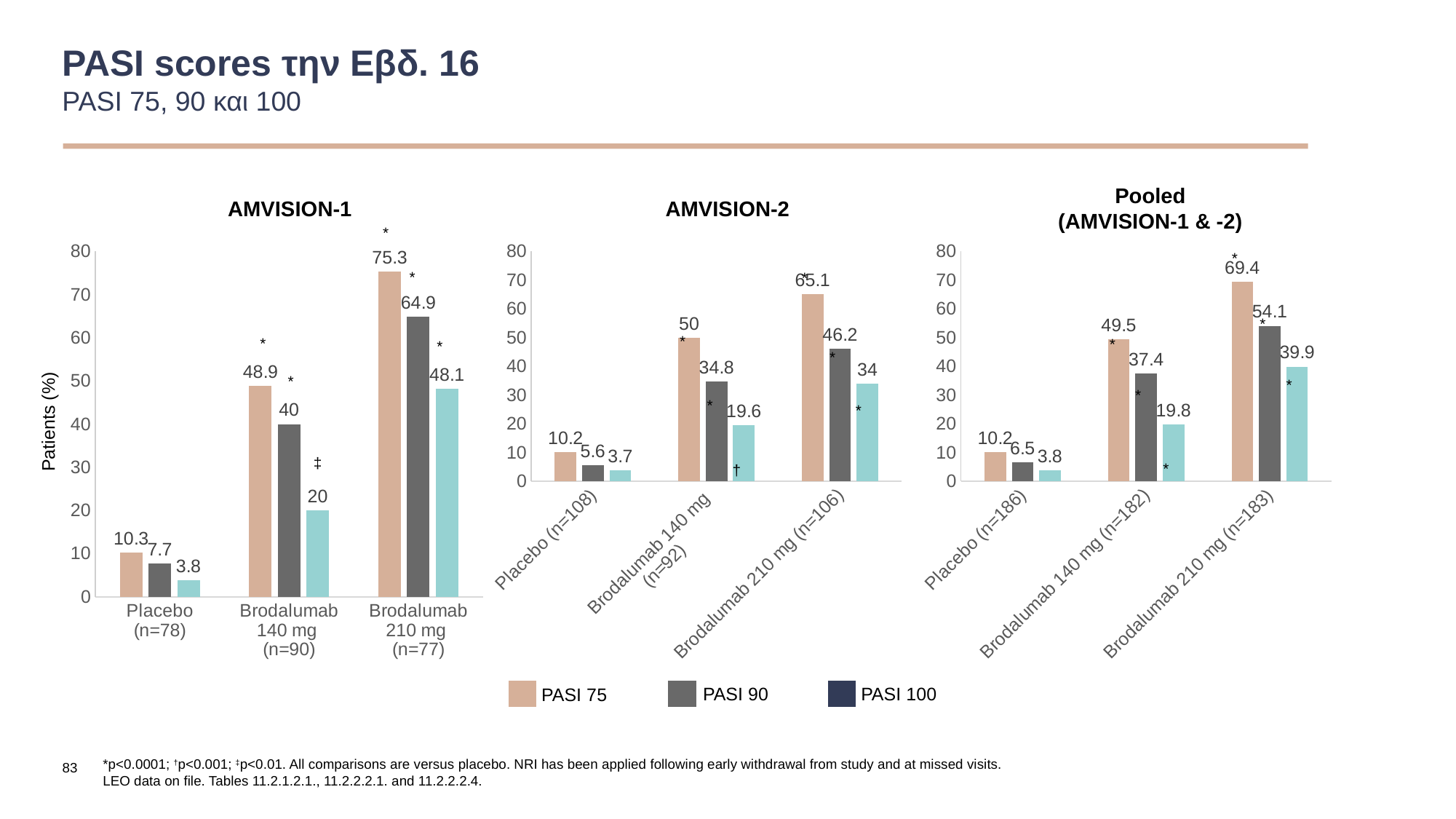
How many series does the legend list? 3 In the Pooled (AMVISION-1 & -2) chart, what is the PASI 100 value for Brodalumab 210 mg (n=183)? 39.9 In the AMVISION-1 chart, what is the PASI 75 value for Brodalumab 210 mg (n=77)? 75.3 In the Pooled (AMVISION-1 & -2) chart, what is the difference between the PASI 75 values for Brodalumab 210 mg (n=183) and Placebo (n=186)? 59.2 What type of chart is the Pooled (AMVISION-1 & -2) chart? Bar chart In the AMVISION-2 chart, what is the PASI 90 value for Brodalumab 140 mg (n=92)? 34.8 In the AMVISION-2 chart, which treatment group has the lowest PASI 100 value? Placebo (n=108) How many treatment groups are shown on the x axis of the AMVISION-2 chart? 3 In the AMVISION-2 chart, is the PASI 75 value for Brodalumab 210 mg (n=106) greater or less than 60? greater In the AMVISION-1 chart, which treatment group has the highest PASI 75 value? Brodalumab 210 mg (n=77) What is the y-axis label of the AMVISION-1 chart? Patients (%) In the AMVISION-1 chart, which is larger: the PASI 90 value for Brodalumab 140 mg (n=90) or the PASI 100 value for Brodalumab 210 mg (n=77)? PASI 100 for Brodalumab 210 mg (n=77)